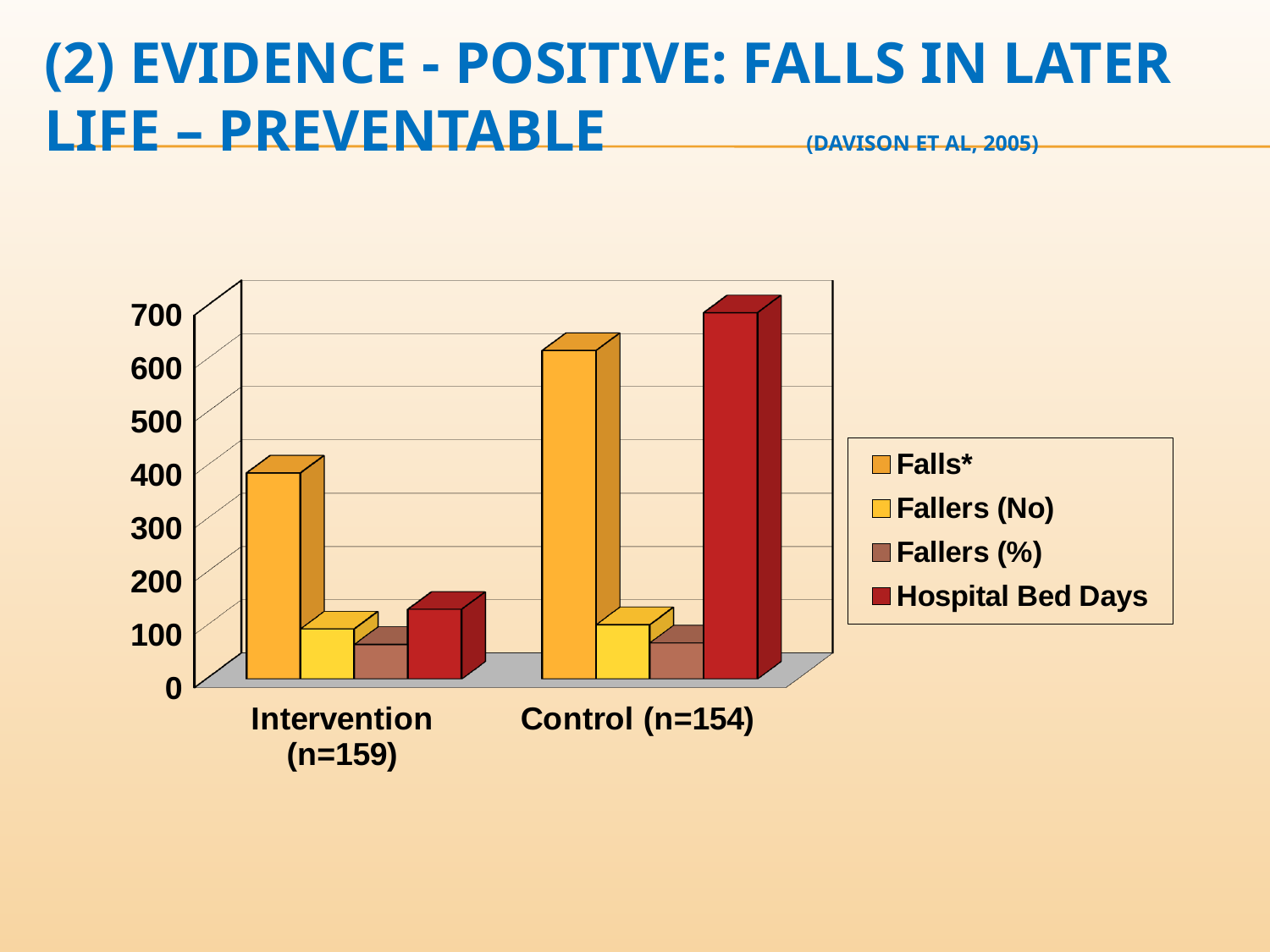
Is the Falls* value for Control (n=154) greater or less than 500? greater Is the Hospital Bed Days value for Intervention (n=159) greater or less than 200? less Which series has the shortest bar in the Intervention (n=159) group? Fallers (%) Is the Hospital Bed Days value larger for Intervention (n=159) or for Control (n=154)? Control (n=154) Is the Falls* value larger for Intervention (n=159) or for Control (n=154)? Control (n=154) How many categories are shown on the x axis of the chart? 2 What colour represents the Hospital Bed Days series in the legend? red Is the Falls* value for Intervention (n=159) greater or less than 300? greater What kind of chart is shown on the slide? bar chart Which series has the tallest bar in the Control (n=154) group? Hospital Bed Days Which series has the tallest bar in the Intervention (n=159) group? Falls* How many series does the chart's legend list? 4